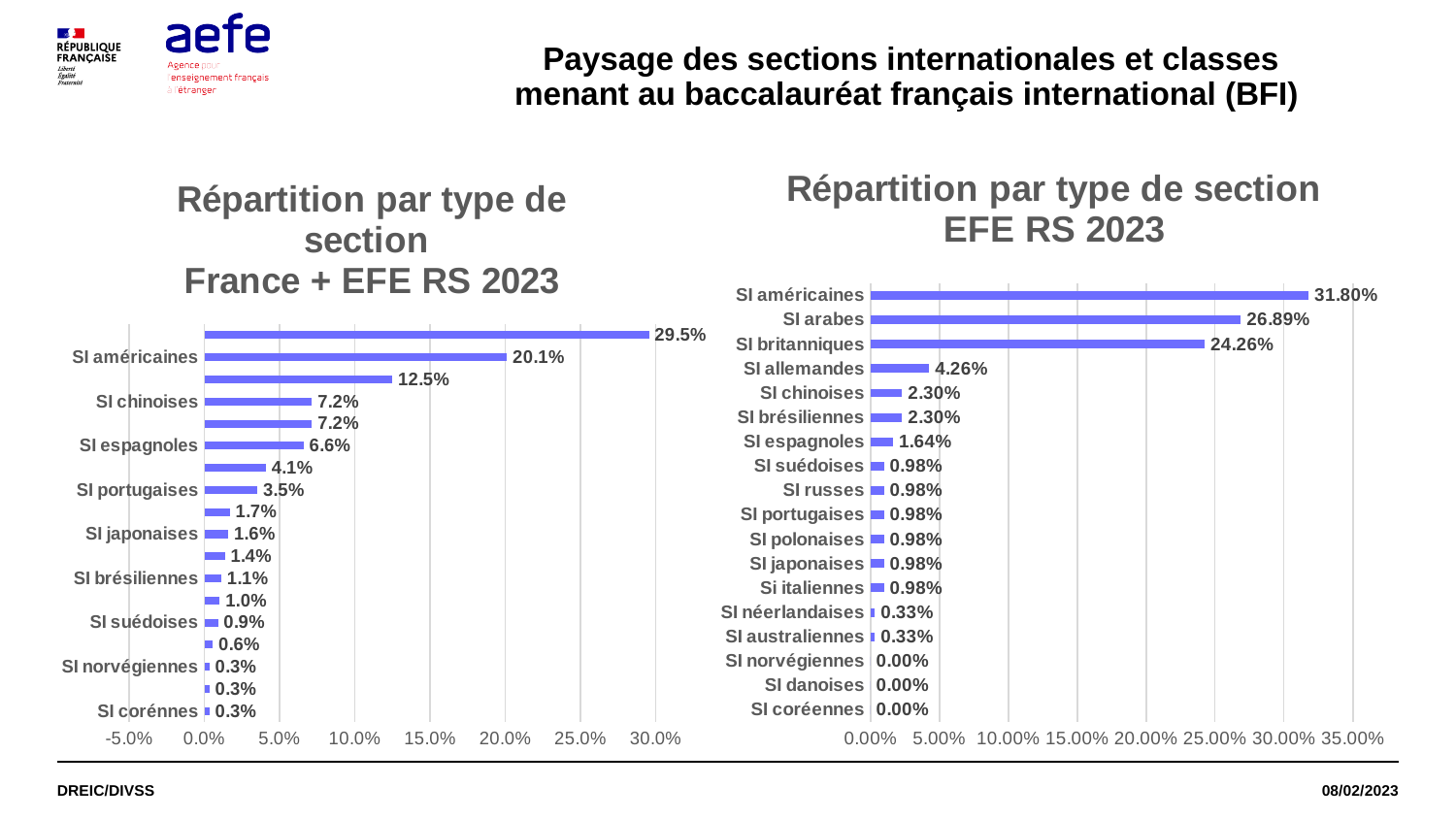
In the chart titled 'Répartition par type de section France + EFE RS 2023', what is the value for SI corénnes? 0.3% In the chart titled 'Répartition par type de section EFE RS 2023', what is the value for SI néerlandaises? 0.33% In the chart titled 'Répartition par type de section EFE RS 2023', what is the difference between the values for SI américaines and SI arabes? 4.91 percentage points In the chart titled 'Répartition par type de section EFE RS 2023', what is the value for SI arabes? 26.89% How many section types are listed in the chart titled 'Répartition par type de section EFE RS 2023'? 18 In the chart titled 'Répartition par type de section EFE RS 2023', what is the difference between the values for SI britanniques and SI allemandes? 20.00 percentage points In the chart titled 'Répartition par type de section EFE RS 2023', which section type has the highest value? SI américaines In the chart titled 'Répartition par type de section EFE RS 2023', what is the value for SI allemandes? 4.26% What kind of chart is the chart titled 'Répartition par type de section EFE RS 2023'? Bar chart In the chart titled 'Répartition par type de section France + EFE RS 2023', what is the highest value shown? 29.5% In the chart titled 'Répartition par type de section EFE RS 2023', how many section types show a value of 0.00%? 3 In the chart titled 'Répartition par type de section EFE RS 2023', which is larger: the value for SI britanniques or the value for SI allemandes? SI britanniques